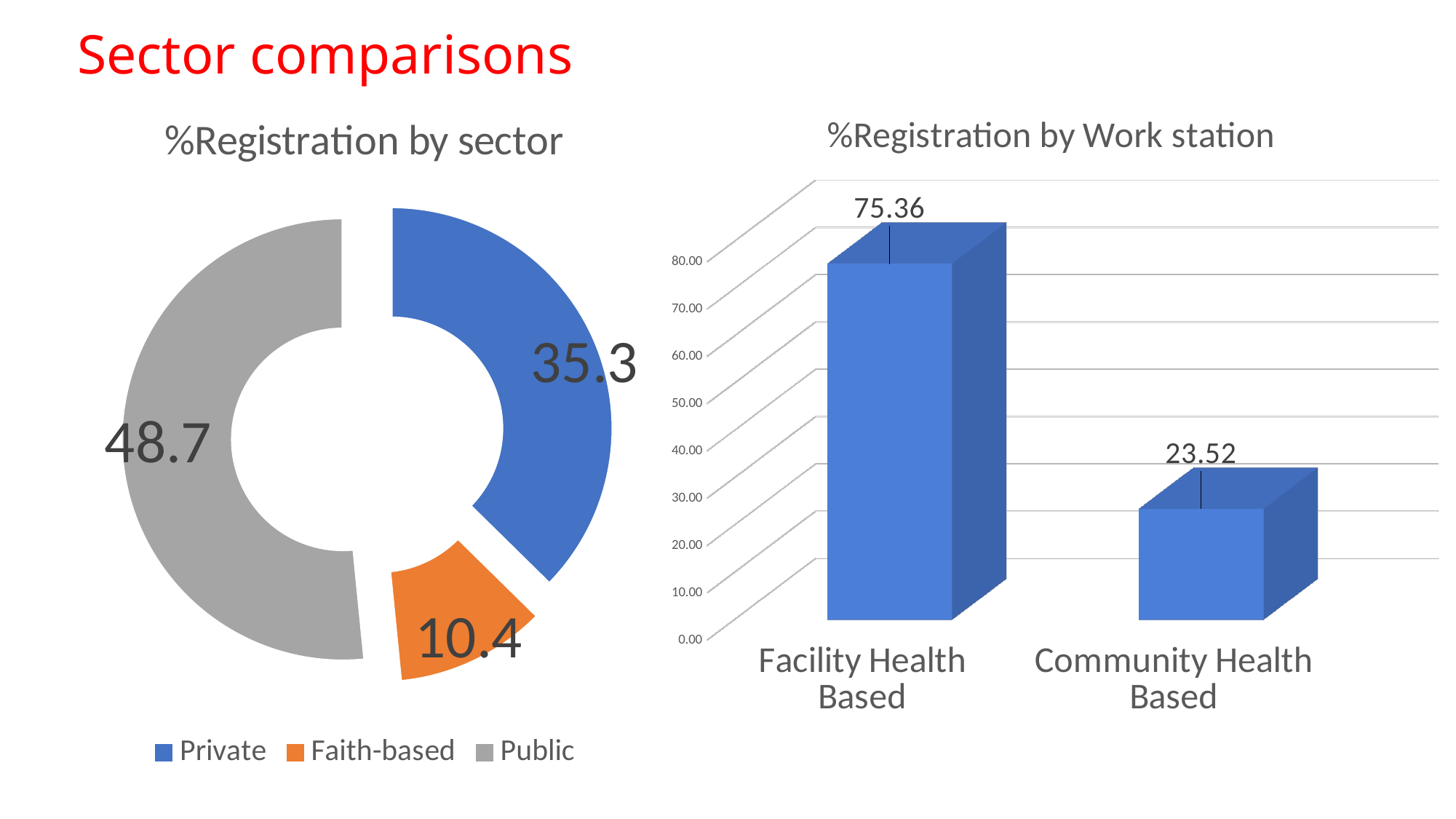
What kind of chart is '%Registration by sector'? Doughnut chart In the '%Registration by sector' chart, what is the value for Faith-based? 10.4 In the '%Registration by sector' chart, what is the value for Public? 48.7 In the '%Registration by Work station' chart, what is the value for Facility Health Based? 75.36 In the '%Registration by Work station' chart, how many categories are shown? 2 In the '%Registration by Work station' chart, what is the value for Community Health Based? 23.52 In the '%Registration by Work station' chart, what is the difference between Facility Health Based and Community Health Based? 51.84 In the '%Registration by sector' chart, which sector has the largest share? Public In the '%Registration by sector' chart, how many sectors does the legend list? 3 In the '%Registration by sector' chart, what is the difference between the Public and Private values? 13.4 What kind of chart is '%Registration by Work station'? Bar chart In the '%Registration by sector' chart, which sector has the smallest share? Faith-based